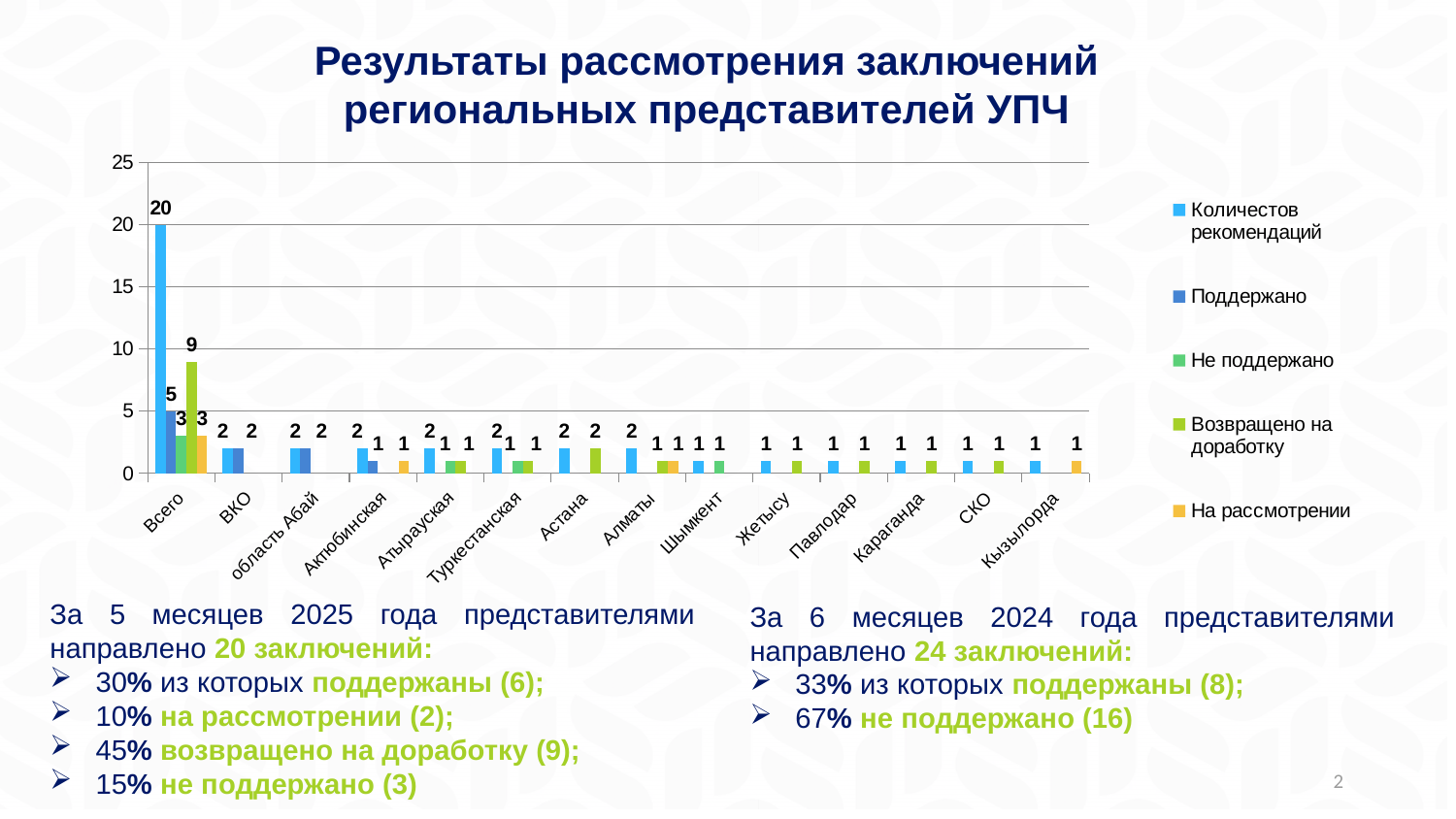
Which category has the highest value of Количестов рекомендаций? Всего What is the value of Количестов рекомендаций for Кызылорда? 1 What is the value of Поддержано for Всего? 5 What is the value of Возвращено на доработку for Всего? 9 How many series does the legend list? 5 What is the difference between Количестов рекомендаций and Возвращено на доработку for Всего? 11 What is the value of Количестов рекомендаций for Всего? 20 How many categories are shown on the x axis? 14 What is the title of the chart on the slide? Результаты рассмотрения заключений региональных представителей УПЧ Is the value of Количестов рекомендаций for Всего greater or less than 15? greater What kind of chart is shown on the slide? Bar chart Which is larger for Всего: Поддержано or Возвращено на доработку? Возвращено на доработку